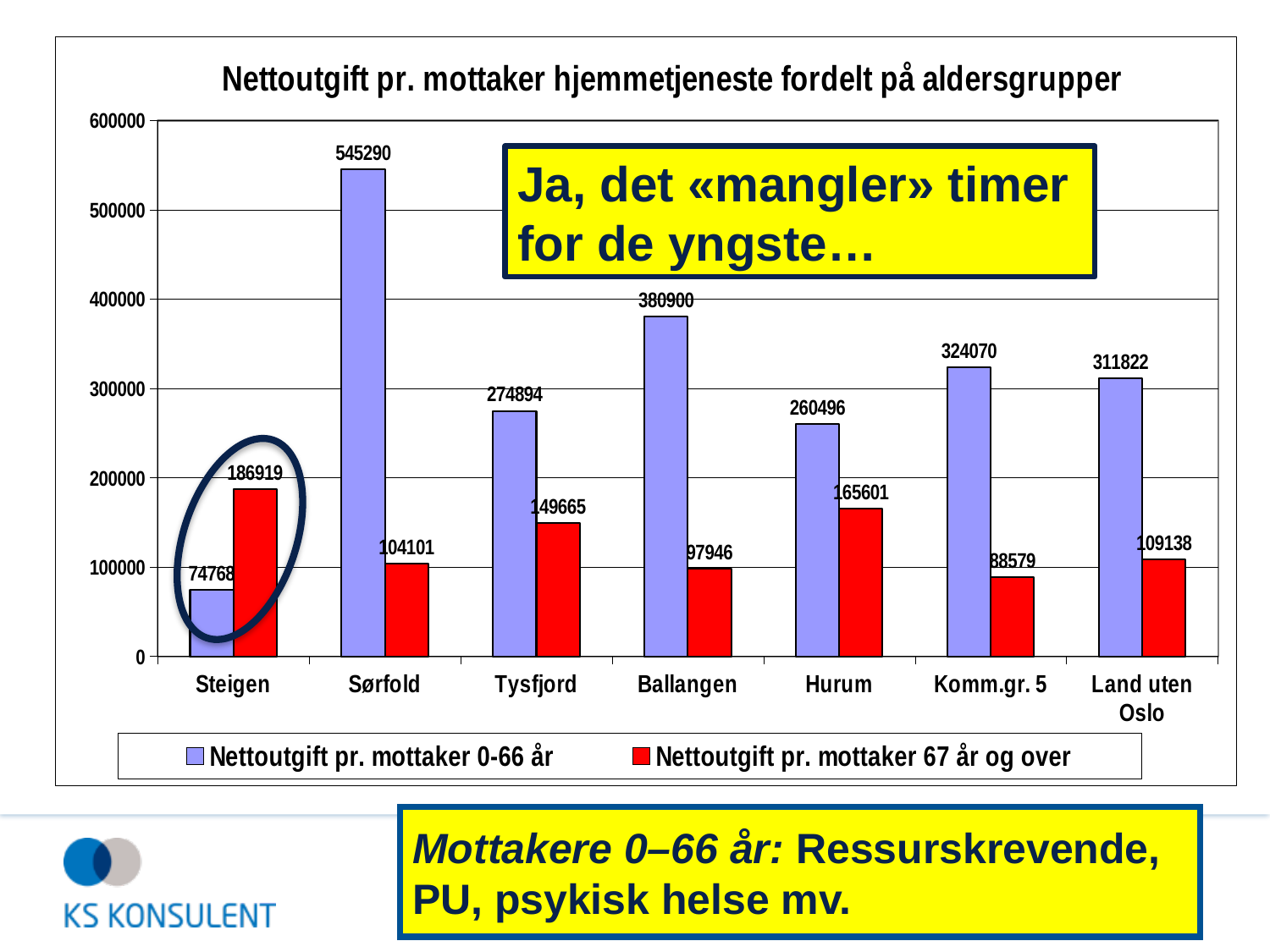
What kind of chart is shown on the slide? Bar chart Is the value of Nettoutgift pr. mottaker 0-66 år for Komm.gr. 5 greater or less than 300000? greater What is the value of Nettoutgift pr. mottaker 0-66 år for Sørfold? 545290 Which is larger for Ballangen: Nettoutgift pr. mottaker 0-66 år or Nettoutgift pr. mottaker 67 år og over? Nettoutgift pr. mottaker 0-66 år What is the value of Nettoutgift pr. mottaker 67 år og over for Land uten Oslo? 109138 How many categories are shown on the x axis? 7 What is the value of Nettoutgift pr. mottaker 0-66 år for Hurum? 260496 What is the value of Nettoutgift pr. mottaker 67 år og over for Steigen? 186919 What is the difference between the 67 år og over value and the 0-66 år value for Steigen? 112151 How many series does the legend list? 2 Which category has the highest value for Nettoutgift pr. mottaker 0-66 år? Sørfold Which category has the lowest value for Nettoutgift pr. mottaker 67 år og over? Komm.gr. 5